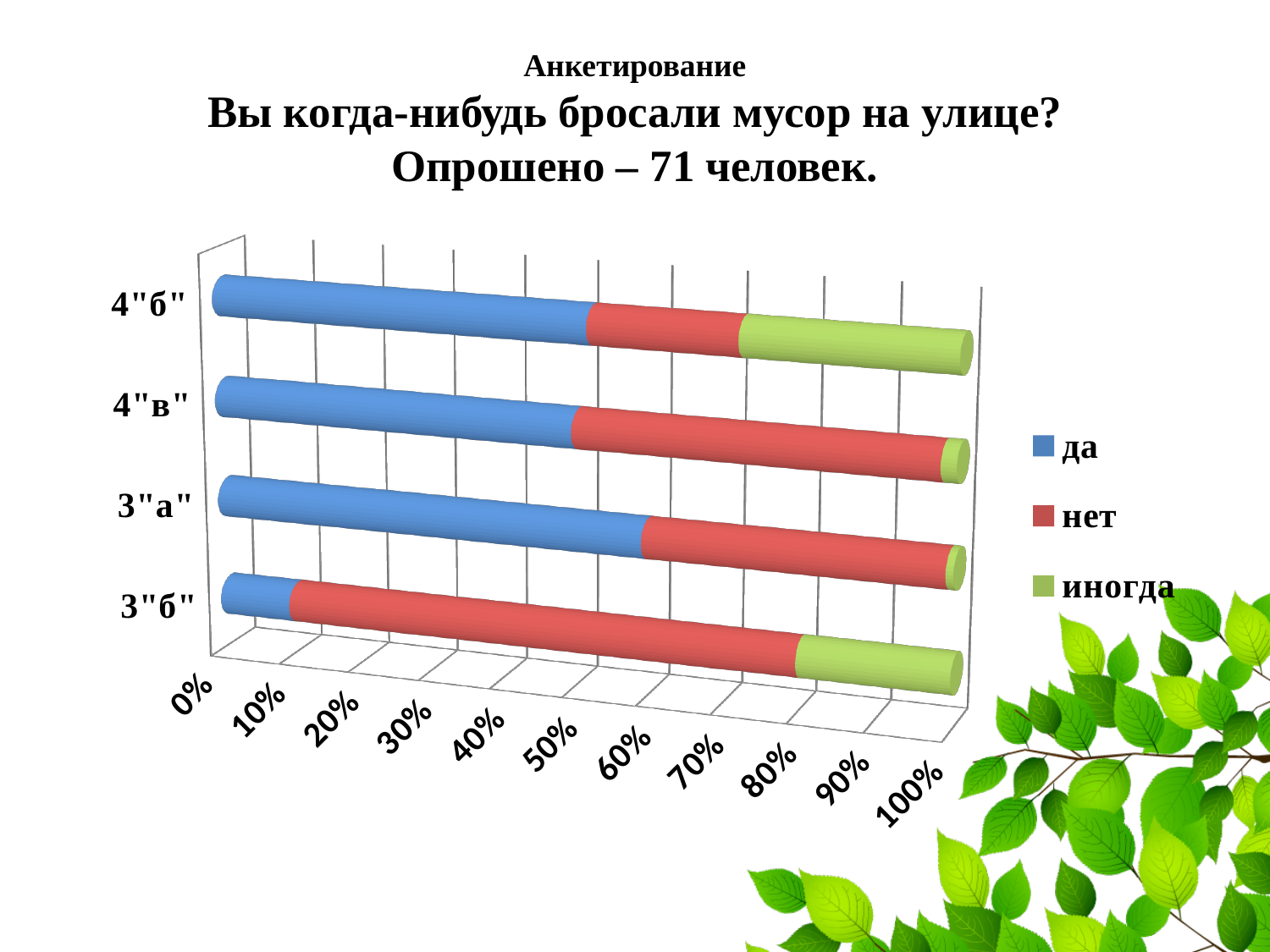
Which class has the largest share of "иногда" answers? 4"б" Which class has the smallest share of "да" answers? 3"б" What kind of chart is shown on the slide? stacked bar chart How many series does the legend list? 3 What are the three entries in the chart legend? да, нет, иногда Which class has the largest share of "нет" answers? 3"б" Is the share of "да" answers for 3"б" greater or less than 30%? less How many classes (categories) are shown on the chart? 4 Which colour represents the answer "нет" in the chart? red Is the share of "иногда" answers for 4"в" greater or less than 10%? less Is the share of "нет" answers for 3"б" greater or less than 50%? greater Which class has a larger share of "да" answers, 4"б" or 3"б"? 4"б"